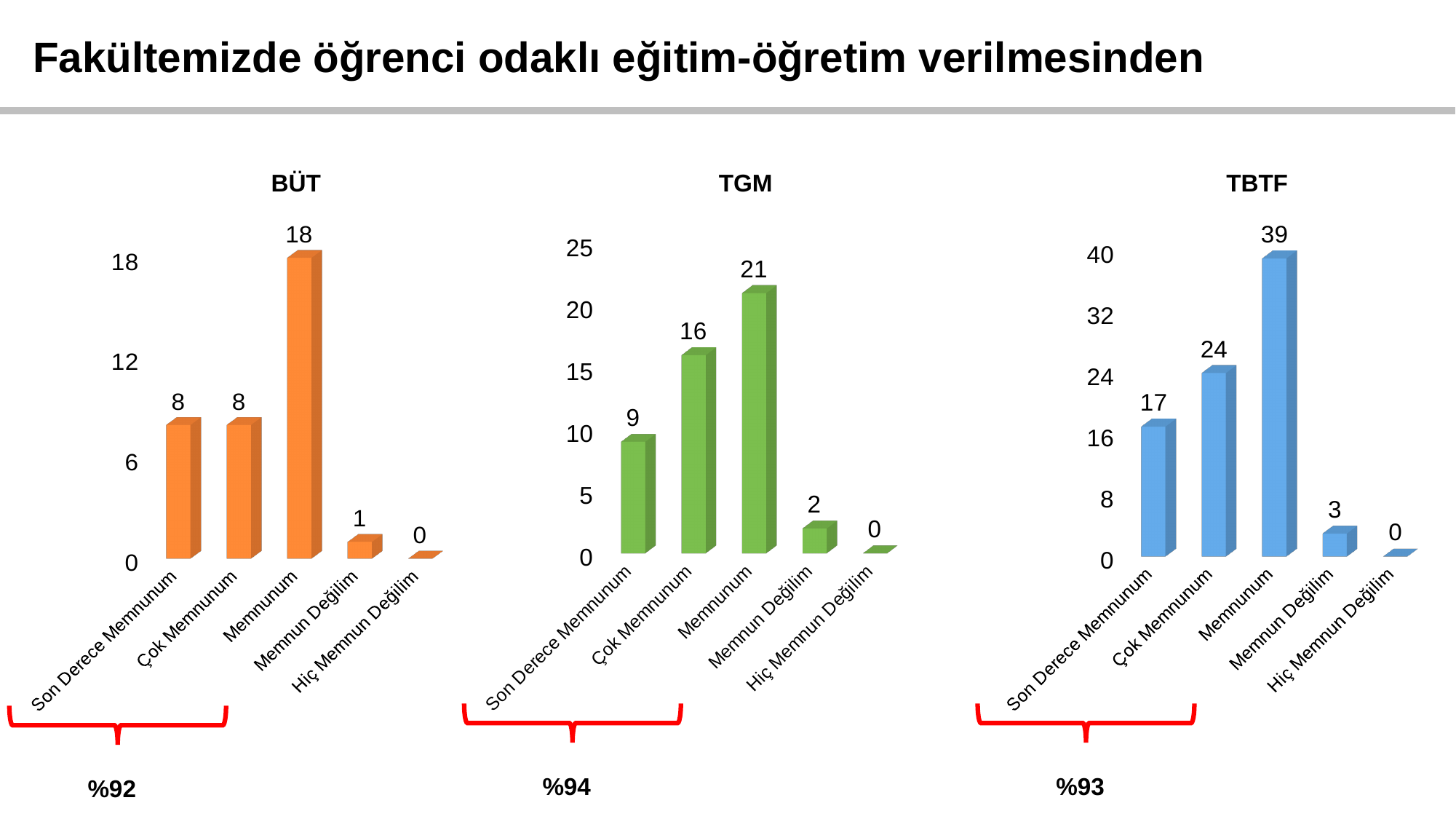
What kind of chart is the BÜT chart? bar chart In the BÜT chart, which is larger: Memnunum or Memnun Değilim? Memnunum In the BÜT chart, what is the value for Memnunum? 18 What percentage is shown under the bracket below the TGM chart? %94 How many categories does the TGM chart show? 5 In the TBTF chart, what is the difference between Memnunum and Çok Memnunum? 15 What colour are the bars in the TBTF chart? blue In the TBTF chart, what is the value for Son Derece Memnunum? 17 In the TBTF chart, which category has the highest value? Memnunum In the TGM chart, what is the value for Çok Memnunum? 16 In the TGM chart, what is the difference between Memnunum and Son Derece Memnunum? 12 In the TGM chart, which category has the lowest value? Hiç Memnun Değilim